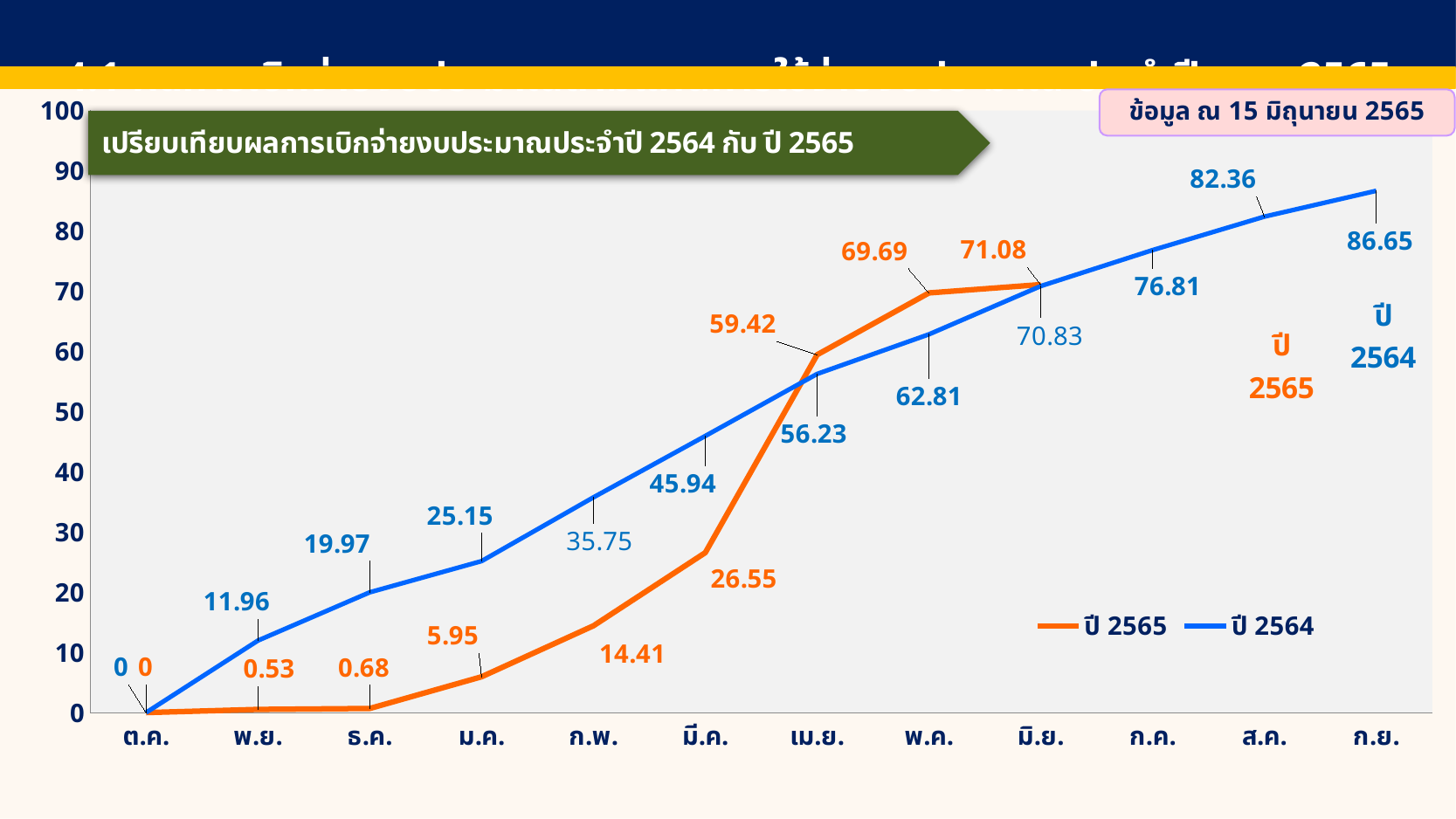
What is the value for ปี 2565 in เม.ย.? 59.42 What is the value for ปี 2564 in ก.ย.? 86.65 What type of chart is shown on the slide? line chart What is the difference between ปี 2564 and ปี 2565 in มี.ค.? 19.39 What colour is the line for ปี 2565? orange What is the value for ปี 2565 in ม.ค.? 5.95 How many months are shown on the x axis? 12 What is the value for ปี 2564 in ก.พ.? 35.75 How many series does the legend list? 2 In which month does the ปี 2565 series reach its highest value? มิ.ย. Which series has the larger value in พ.ค., ปี 2564 or ปี 2565? ปี 2565 Does the ปี 2564 series rise or fall from ต.ค. to ก.ย.? rise